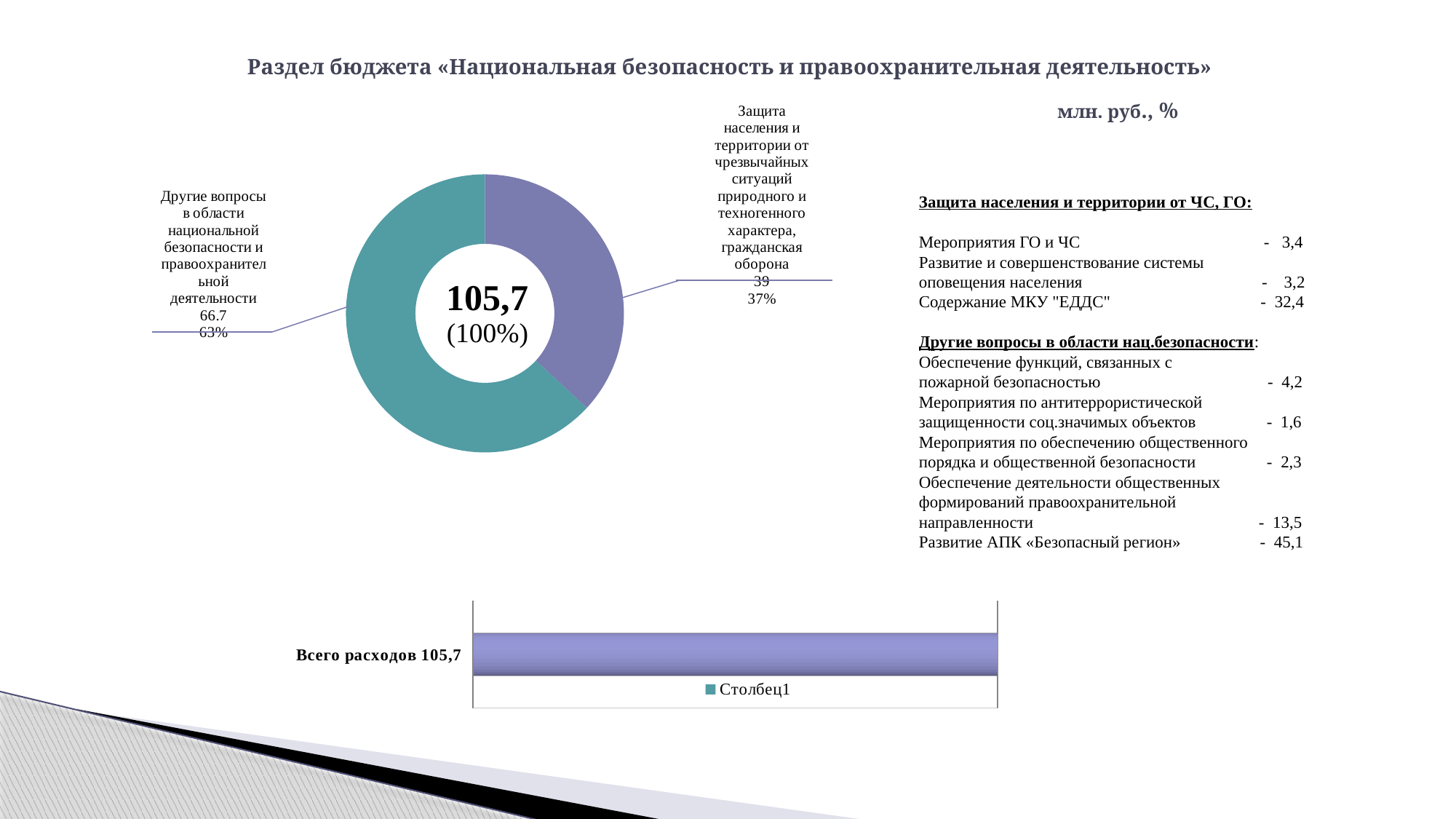
In the doughnut chart, which category has the larger slice? Другие вопросы в области национальной безопасности и правоохранительной деятельности In the doughnut chart, which category has the smaller slice? Защита населения и территории от чрезвычайных ситуаций природного и техногенного характера, гражданская оборона In the doughnut chart, what percentage share is shown for «Защита населения и территории от чрезвычайных ситуаций...»? 37% In the doughnut chart, what value is shown for «Защита населения и территории от чрезвычайных ситуаций природного и техногенного характера, гражданская оборона»? 39 In the doughnut chart, what value is shown for «Другие вопросы в области национальной безопасности и правоохранительной деятельности»? 66.7 What total value is shown in the centre of the doughnut chart? 105,7 (100%) How many slices does the doughnut chart have? 2 In the doughnut chart, what percentage share is shown for «Другие вопросы в области национальной безопасности и правоохранительной деятельности»? 63% What kind of chart is the chart at the bottom of the slide? Bar chart In the bar chart at the bottom of the slide, what is the category label of the single bar? Всего расходов 105,7 In the bar chart at the bottom of the slide, what entry does the legend list? Столбец1 In the doughnut chart, what is the difference between the values for «Другие вопросы...» (66.7) and «Защита населения...» (39)? 27.7